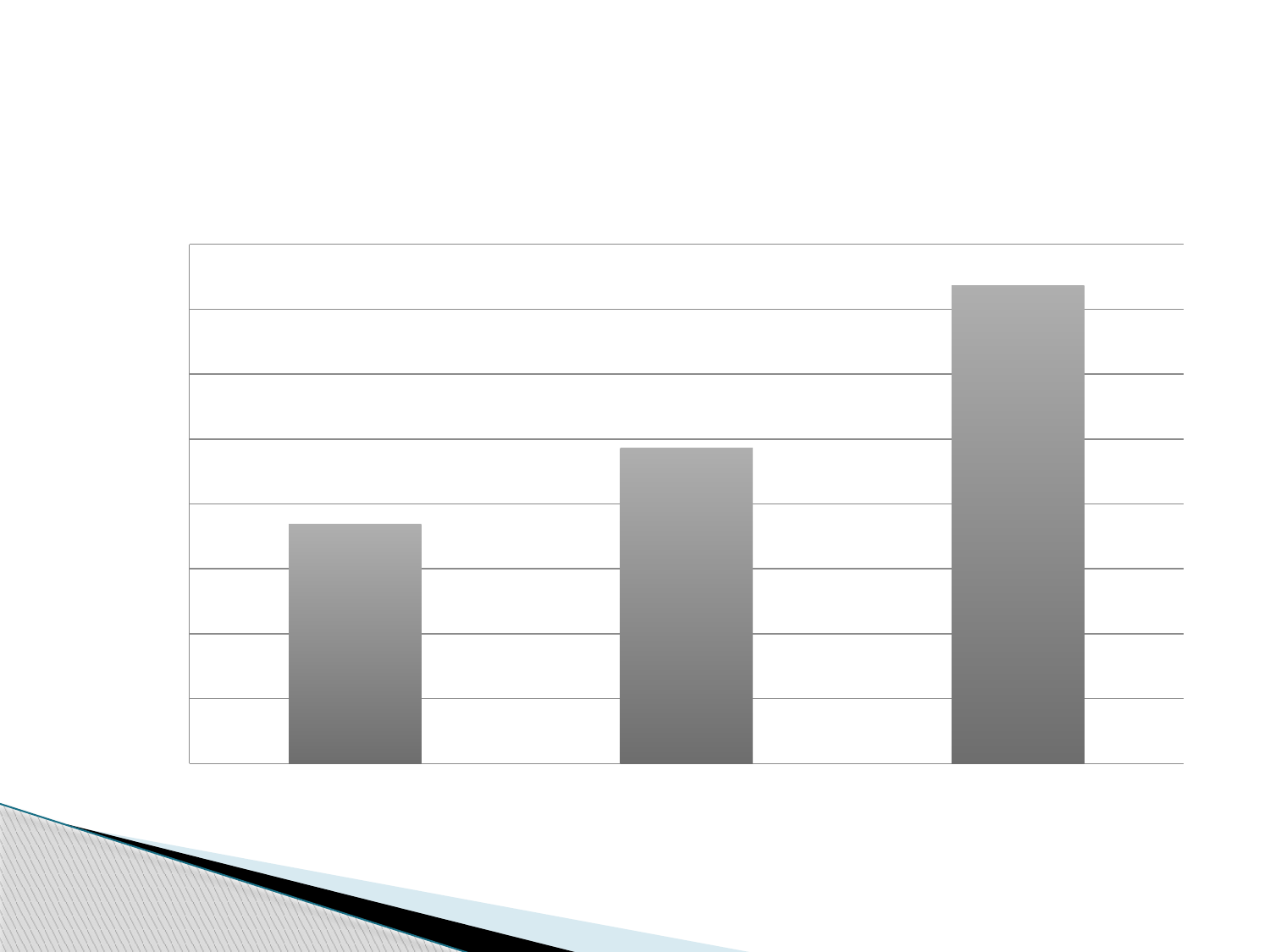
Does the chart display a legend? no Are the bars in the chart vertical or horizontal? vertical How many bars are plotted in the chart? 3 Which is taller, the left bar or the middle bar? middle bar Which bar is the tallest: the left, middle, or right bar? right Which bar is the shortest: the left, middle, or right bar? left Which is taller, the middle bar or the right bar? right bar What kind of chart is shown on the slide? bar chart Do the bar heights rise or fall from left to right across the chart? rise